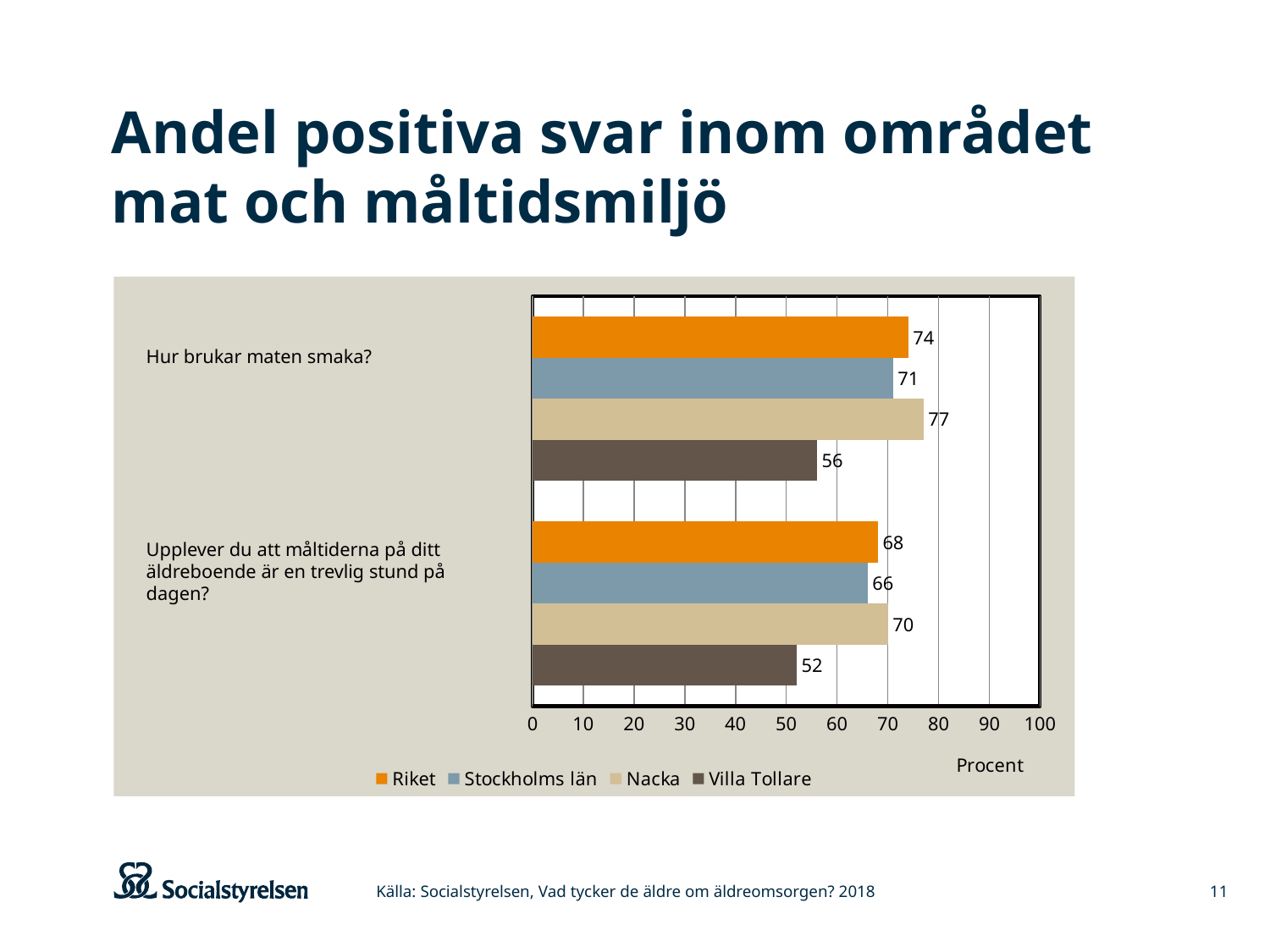
What is the label on the horizontal axis of the chart? Procent What is the difference between Riket and Stockholms län on the question "Upplever du att måltiderna på ditt äldreboende är en trevlig stund på dagen?"? 2 What is the value for Nacka on the question "Hur brukar maten smaka?"? 77 What is the value for Riket on the question "Hur brukar maten smaka?"? 74 What kind of chart is shown on the slide? Bar chart What is the value for Villa Tollare on the question "Upplever du att måltiderna på ditt äldreboende är en trevlig stund på dagen?"? 52 How many series does the legend list? 4 What is the difference between Nacka and Villa Tollare on the question "Hur brukar maten smaka?"? 21 What is the value for Stockholms län on the question "Upplever du att måltiderna på ditt äldreboende är en trevlig stund på dagen?"? 66 Which is larger: Villa Tollare on "Hur brukar maten smaka?" or Villa Tollare on "Upplever du att måltiderna på ditt äldreboende är en trevlig stund på dagen?"? Hur brukar maten smaka? Which series has the highest value on the question "Hur brukar maten smaka?"? Nacka Which series has the lowest value on the question "Upplever du att måltiderna på ditt äldreboende är en trevlig stund på dagen?"? Villa Tollare